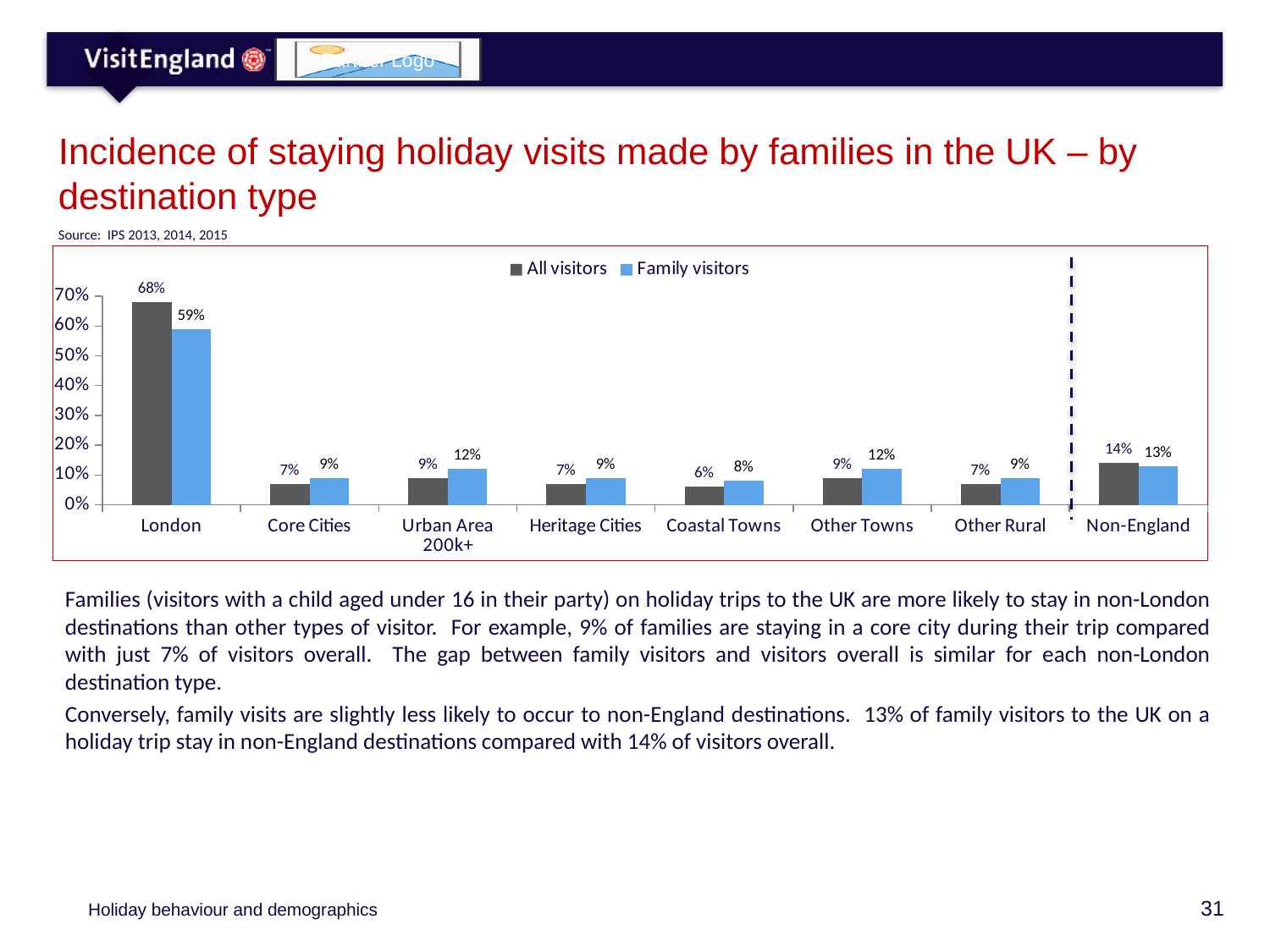
What is the value for Family visitors in Non-England? 13% What is the difference between All visitors and Family visitors in London? 9% Is the value for All visitors in London greater or less than 60%? greater What is the value for All visitors in London? 68% How many destination types are shown on the x axis? 8 Which destination type has the lowest value for All visitors? Coastal Towns What is the value for Family visitors in Coastal Towns? 8% Which is larger in Non-England: All visitors or Family visitors? All visitors How many series does the legend list? 2 What is the difference between Family visitors and All visitors in Urban Area 200k+? 3% Which destination type has the highest value for Family visitors? London What kind of chart is shown on the slide? Bar chart